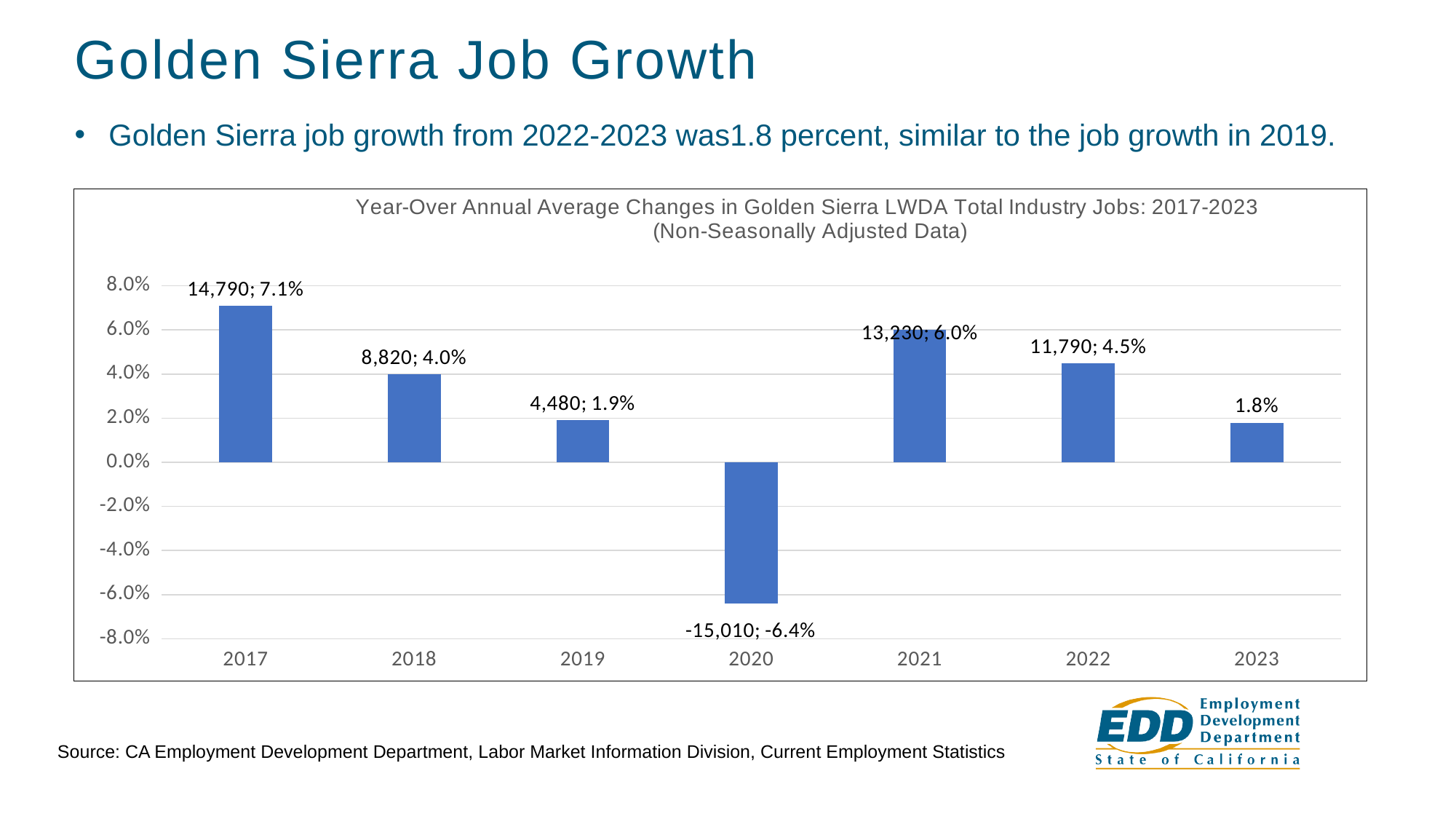
How many years are shown on the x axis of the chart? 7 Which year has a larger percentage change, 2018 or 2019? 2018 What kind of chart is used to show the year-over annual average changes? Bar chart Which year has the highest percentage change in total industry jobs? 2017 Which year has the lowest percentage change in total industry jobs? 2020 What is the number of jobs change shown for 2021? 13,230 Do the percentage changes rise or fall from 2021 to 2023? Fall What is the percentage change in total industry jobs shown for 2017? 7.1% What is the job change in number of jobs shown for 2020? -15,010 What is the difference in percentage points between the 2021 and 2022 percentage changes? 1.5 What is the percentage change shown for 2023? 1.8% What is the title of the chart? Year-Over Annual Average Changes in Golden Sierra LWDA Total Industry Jobs: 2017-2023 (Non-Seasonally Adjusted Data)